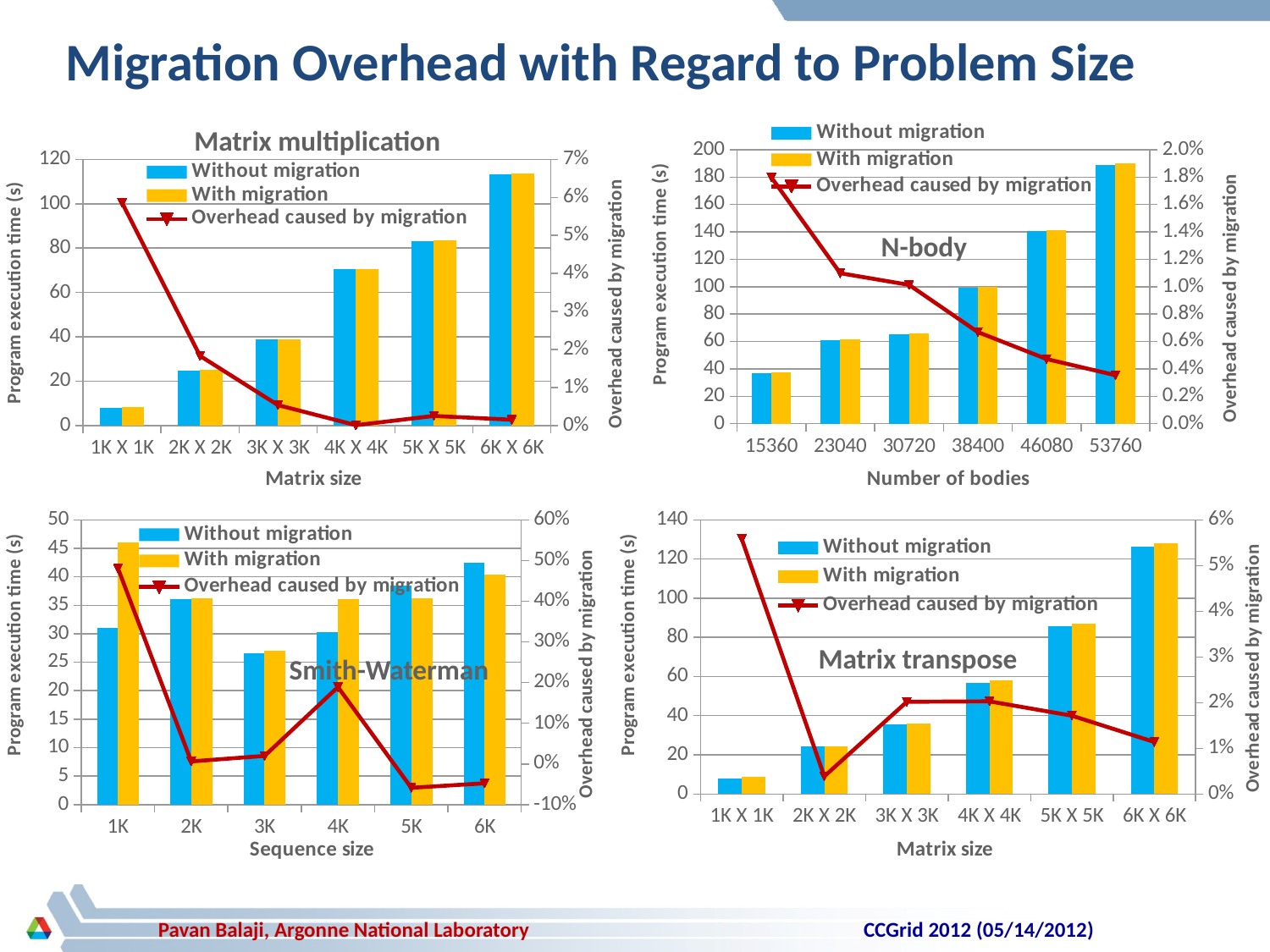
In the Matrix multiplication chart, how many series does the legend list? 3 In the N-body chart, is the overhead caused by migration for 15360 bodies greater or less than 1.6%? greater How many charts are on the slide? 4 In the N-body chart, which number of bodies has the lowest program execution time without migration? 15360 In the Matrix multiplication chart, how many matrix sizes are shown on the x axis? 6 In the Smith-Waterman chart, which sequence size has the highest program execution time with migration? 1K In the Matrix multiplication chart, which matrix size has the highest program execution time without migration? 6K X 6K In the Matrix transpose chart, which matrix size has the lowest overhead caused by migration? 2K X 2K In the Matrix multiplication chart, is the overhead caused by migration for 1K X 1K greater or less than 5%? greater In the Matrix multiplication chart, is the program execution time without migration for 6K X 6K greater or less than 100? greater In the N-body chart, does the overhead caused by migration rise or fall as the number of bodies increases? fall